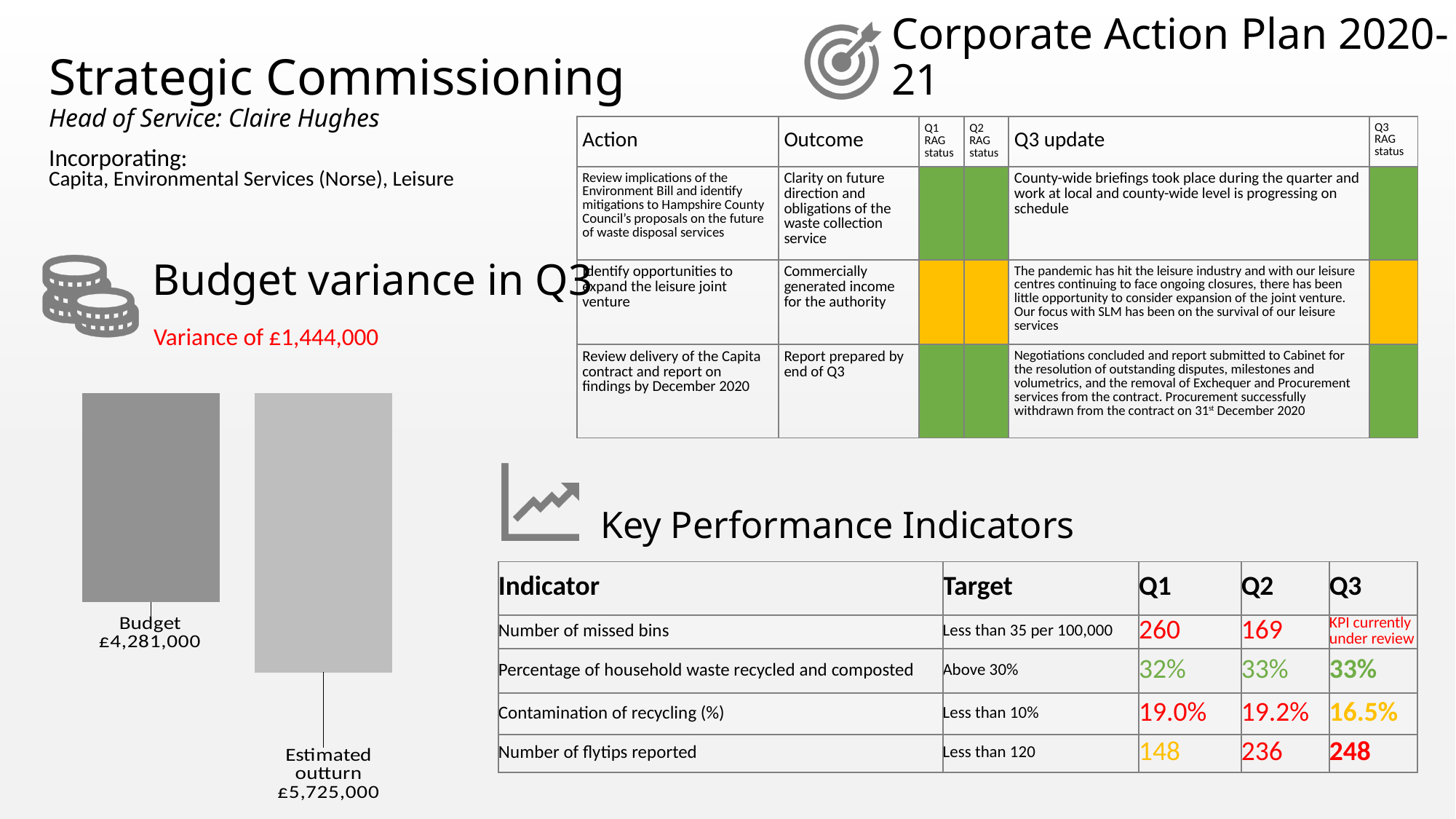
What type of chart is shown under the 'Budget variance in Q3' heading? bar chart What is the heading above the bar chart on the left of the slide? Budget variance in Q3 In the budget variance chart, what is the difference between the Estimated outturn and the Budget? £1,444,000 How many bars are plotted in the budget variance chart? 2 In the budget variance chart, which category has the higher value? Estimated outturn In the budget variance chart, which category has the lower value? Budget In the budget variance chart, is the Budget value larger or smaller than the Estimated outturn value? smaller In the budget variance chart, what is the value for Budget? £4,281,000 In the budget variance chart, what is the value for Estimated outturn? £5,725,000 What variance amount is printed in red above the budget variance chart? Variance of £1,444,000